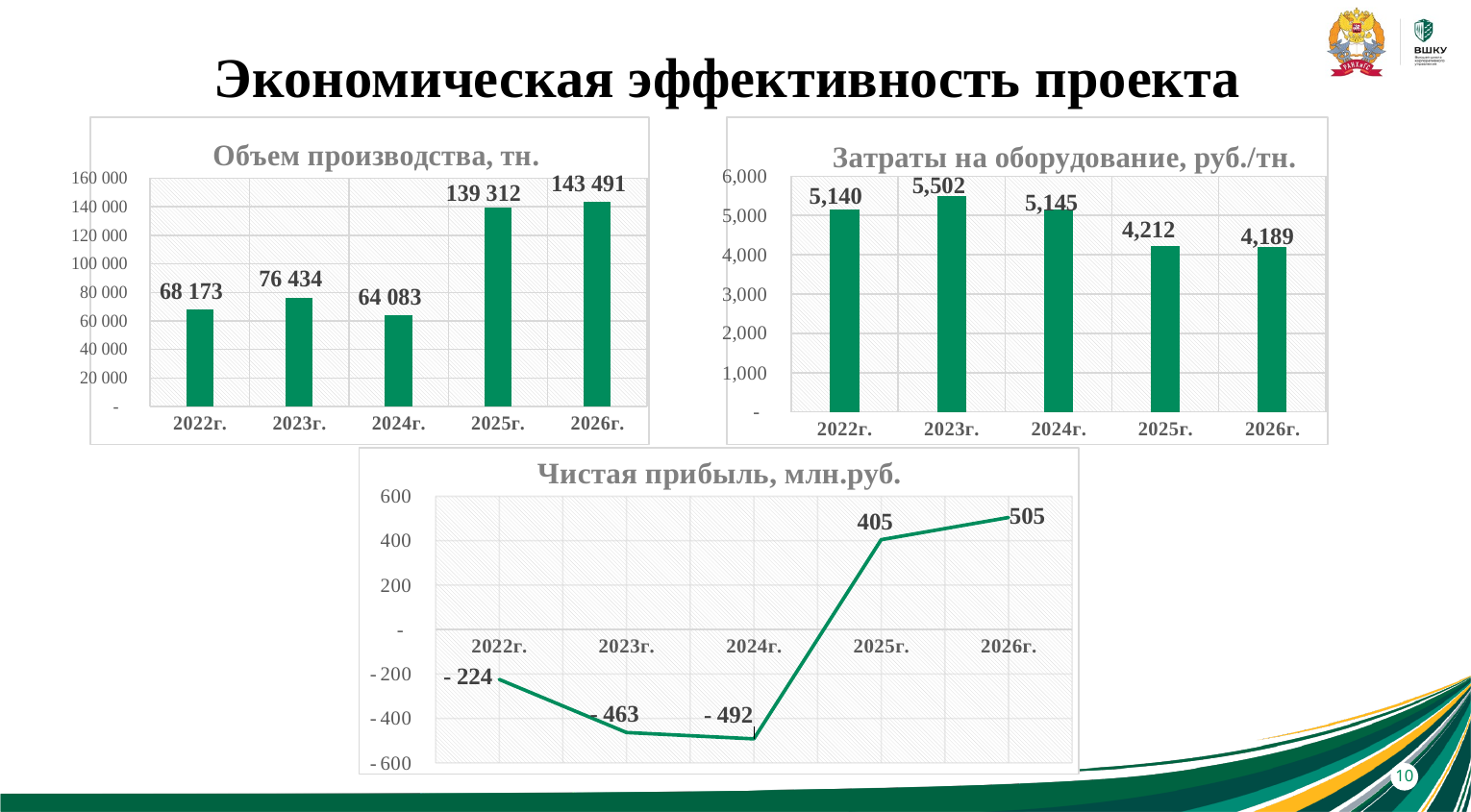
In the chart titled "Затраты на оборудование, руб./тн.", is the value for 2025г. greater or less than 5,000? less In the chart titled "Объем производства, тн.", what is the difference between the values for 2026г. and 2025г.? 4 179 In the chart titled "Затраты на оборудование, руб./тн.", which year has the lowest value? 2026г. In the chart titled "Объем производства, тн.", which year has the lowest value? 2024г. In the chart titled "Затраты на оборудование, руб./тн.", what is the value for 2023г.? 5,502 In the chart titled "Чистая прибыль, млн.руб.", is the value for 2025г. larger than the value for 2022г.? Yes In the chart titled "Объем производства, тн.", what is the value for 2025г.? 139 312 In the chart titled "Чистая прибыль, млн.руб.", which year has the highest value? 2026г. In the chart titled "Чистая прибыль, млн.руб.", what is the value for 2024г.? - 492 In the chart titled "Объем производства, тн.", how many years are shown on the x axis? 5 What kind of chart is the one titled "Чистая прибыль, млн.руб."? line chart In the chart titled "Затраты на оборудование, руб./тн.", what is the difference between the highest and lowest values? 1,313